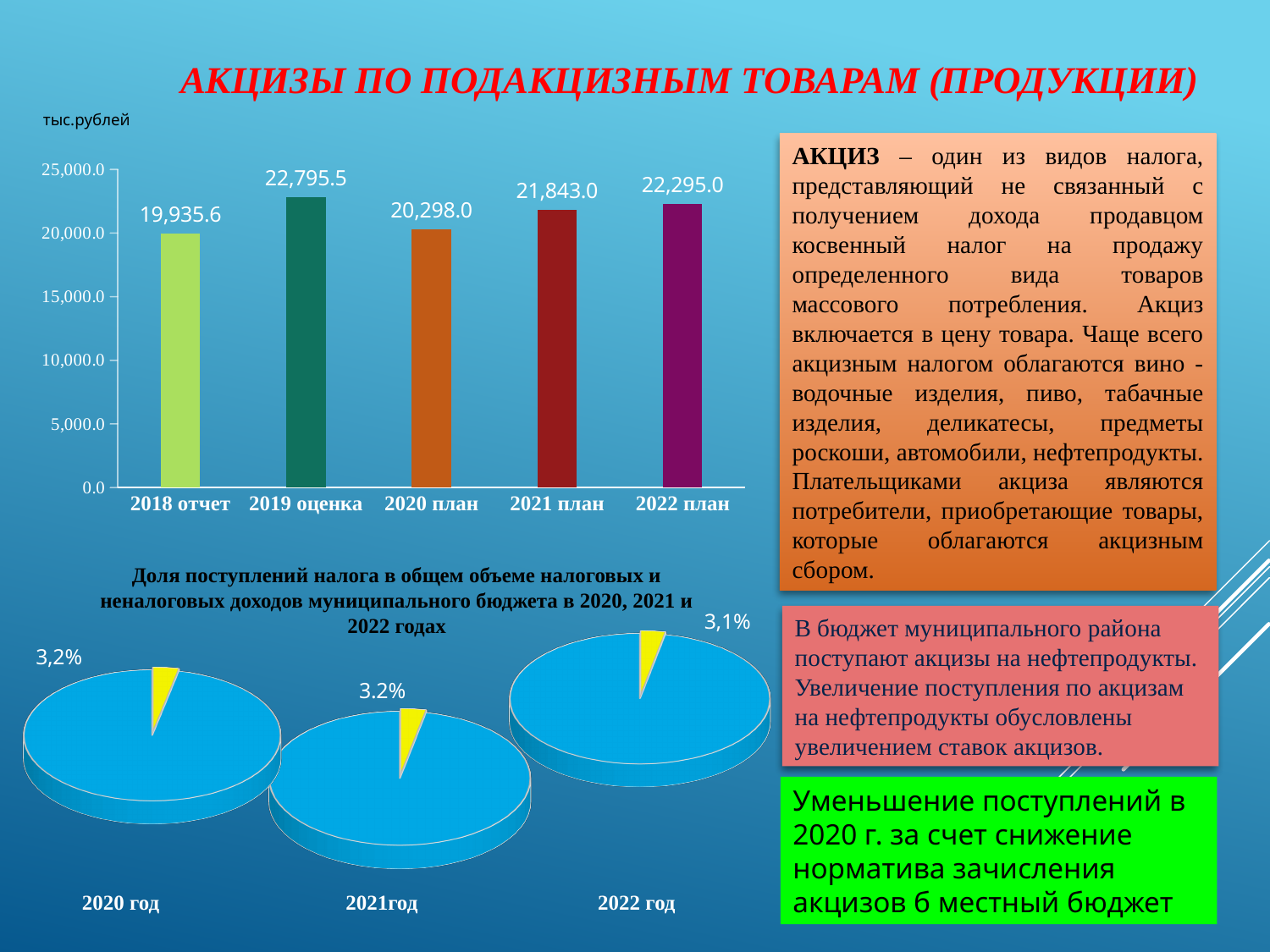
How many bars are in the bar chart at the top left? 5 In the bar chart at the top left, do the values rise or fall from 2020 план to 2022 план? rise In the bar chart at the top left, which category has the highest value? 2019 оценка In the bar chart at the top left, what is the difference between the values for 2022 план and 2021 план? 452.0 In the bar chart at the top left, is the value for 2018 отчет greater or less than 15,000.0? greater In the bar chart at the top left, which is larger: the value for 2020 план or the value for 2021 план? 2021 план In the bar chart at the top left, what is the difference between the values for 2019 оценка and 2018 отчет? 2,859.9 In the bar chart at the top left, which category has the lowest value? 2018 отчет In the pie chart labelled 2022 год at the bottom of the slide, what share is shown for the yellow slice? 3,1% In the bar chart at the top left, what is the value for 2019 оценка? 22,795.5 In the bar chart at the top left, what is the value for 2021 план? 21,843.0 What kind of chart is shown at the top left of the slide? bar chart